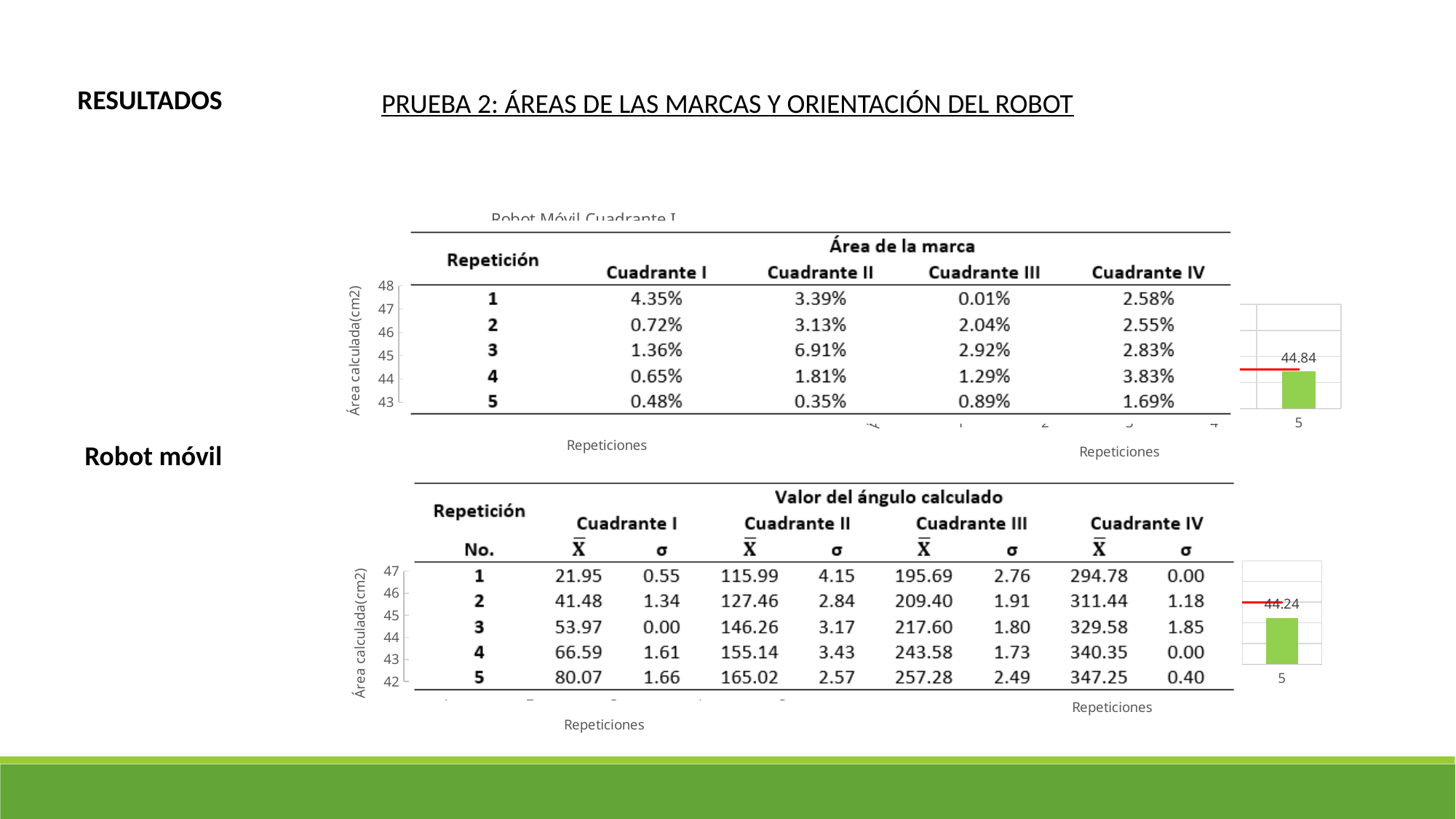
What kind of chart is the chart at the bottom right of the slide? combination bar and line chart What is the difference between the repetition 5 value in the top-right chart (44.84) and the repetition 5 value in the bottom-right chart (44.24)? 0.60 What is the title of the chart at the top left of the slide? Robot Móvil Cuadrante I Which is larger: the repetition 5 value in the top-right chart or the repetition 5 value in the bottom-right chart? the top-right chart (44.84) In the chart at the top right of the slide, what is the value labelled on the bar for repetition 5? 44.84 What is the y-axis label of the chart at the top left of the slide? Área calculada(cm2) In the chart at the bottom right of the slide, what is the value labelled on the bar for repetition 5? 44.24 What kind of chart is the chart at the top right of the slide? combination bar and line chart